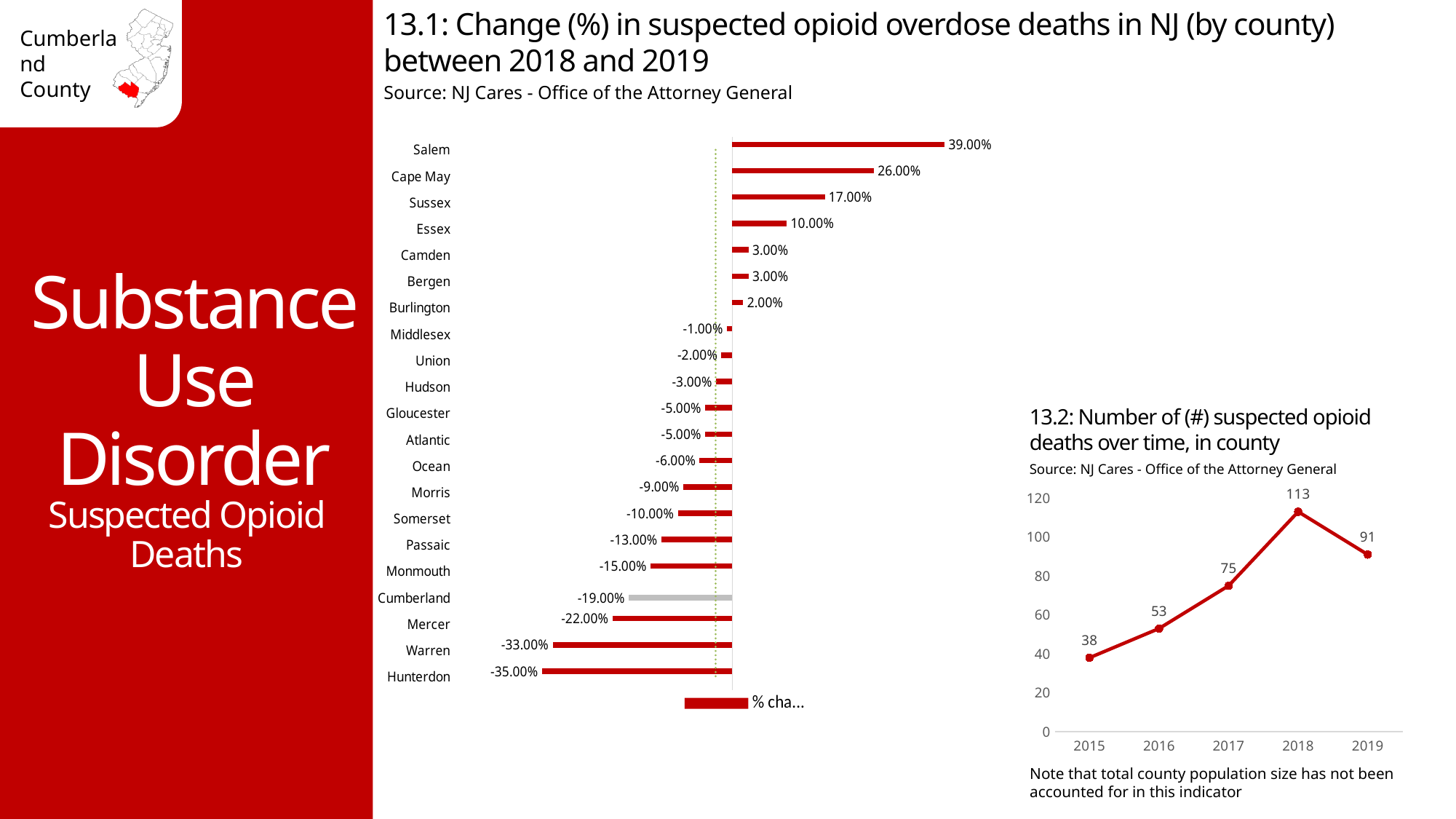
In chart 13.1, what is the change (%) in suspected opioid overdose deaths for Cumberland? -19.00% In chart 13.1, what is the difference between the values for Salem and Cape May? 13.00% In chart 13.2, which year has the lowest number of suspected opioid deaths? 2015 In chart 13.1, how many counties are shown? 21 In chart 13.1, which has a larger value, Essex or Sussex? Sussex In chart 13.1, what is the value for Cape May? 26.00% In chart 13.2, what is the difference between the values for 2018 and 2019? 22 In chart 13.2, what is the number of suspected opioid deaths in 2018? 113 In chart 13.1, which county has the lowest change (%) in suspected opioid overdose deaths? Hunterdon In chart 13.1, which county has the highest change (%) in suspected opioid overdose deaths? Salem What kind of chart is chart 13.2? Line chart What kind of chart is chart 13.1? Bar chart